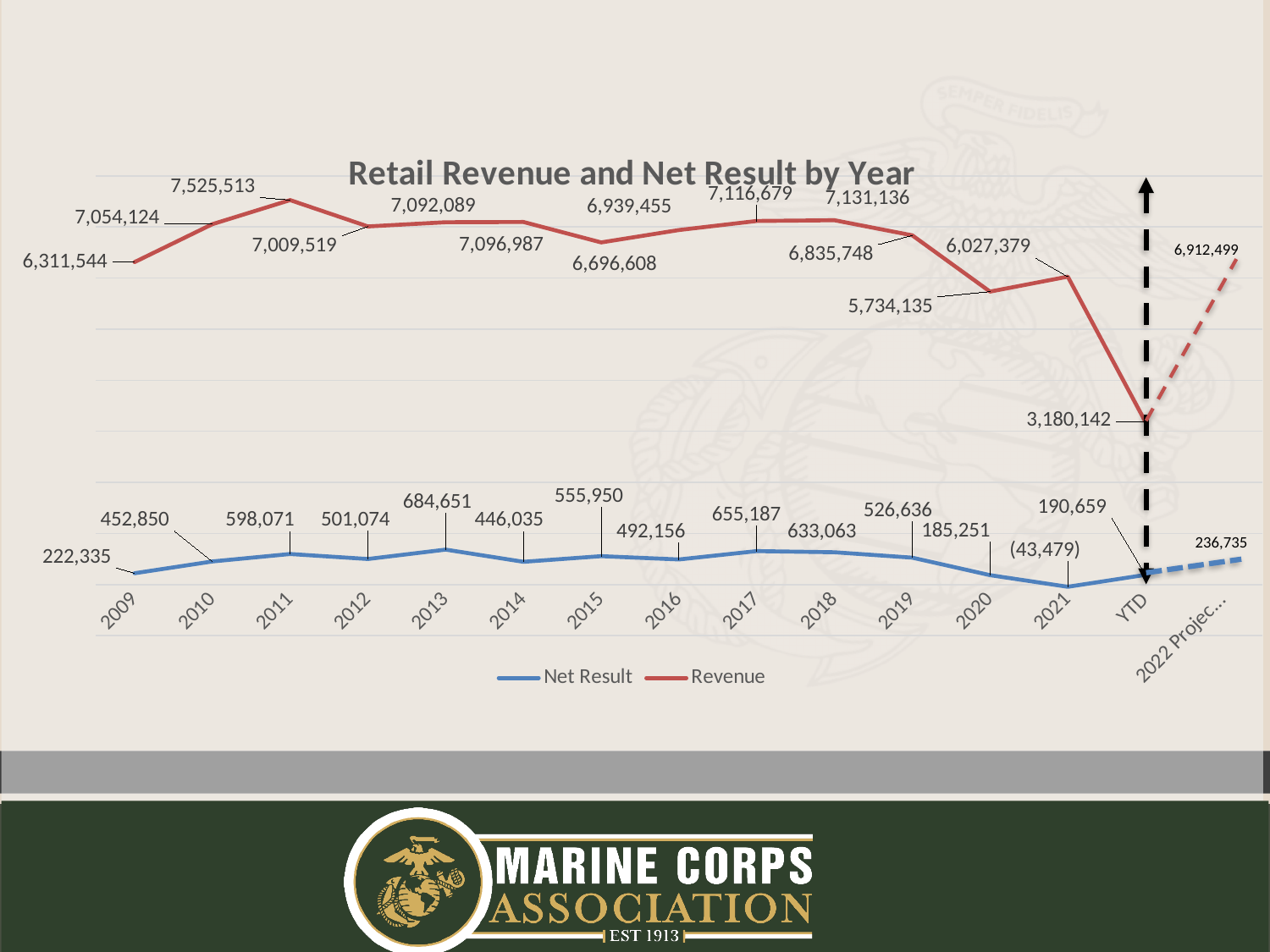
Which year had the larger Net Result, 2017 or 2018? 2017 What is the Revenue value shown for YTD? 3,180,142 How many series does the legend list? 2 What kind of chart is shown on the slide? Line chart What was the Revenue in 2011? 7,525,513 What colour is the Revenue line? Red Which point on the x axis has the lowest Revenue? YTD Which year had the highest Revenue? 2011 Which year had the lowest Net Result? 2021 What was the Net Result in 2013? 684,651 What is the difference between the Revenue in 2018 and the Revenue in 2017? 14,457 How many points are plotted along the x axis for each series? 14